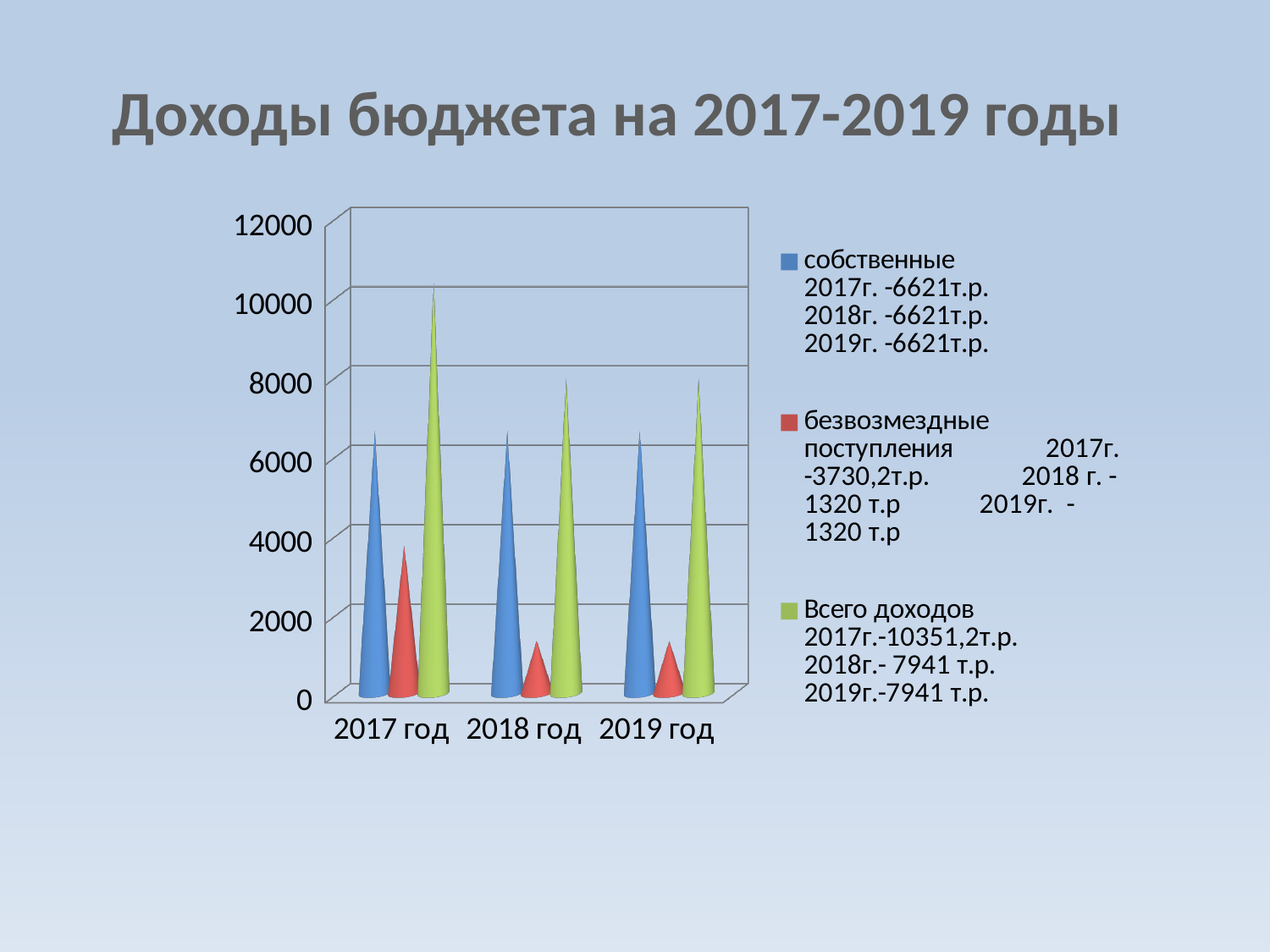
Is the value of 'Всего доходов' for 2017 greater or less than 10000? greater According to the legend, what is the value of 'безвозмездные поступления' for 2017? 3730,2т.р. Which is larger in 2019: 'собственные' or 'безвозмездные поступления'? собственные How many series does the legend list? 3 In which year is 'Всего доходов' the highest? 2017 год According to the legend, what is the value of 'собственные' for 2017? 6621т.р. How many year categories are shown on the x axis? 3 Does 'безвозмездные поступления' rise or fall from 2017 to 2018? fall According to the legend, what is the value of 'Всего доходов' for 2018? 7941 т.р. What kind of chart is shown on the slide? bar chart What is the difference between 'Всего доходов' in 2017 and in 2018? 2410,2 т.р. What is the title of the chart? Доходы бюджета на 2017-2019 годы